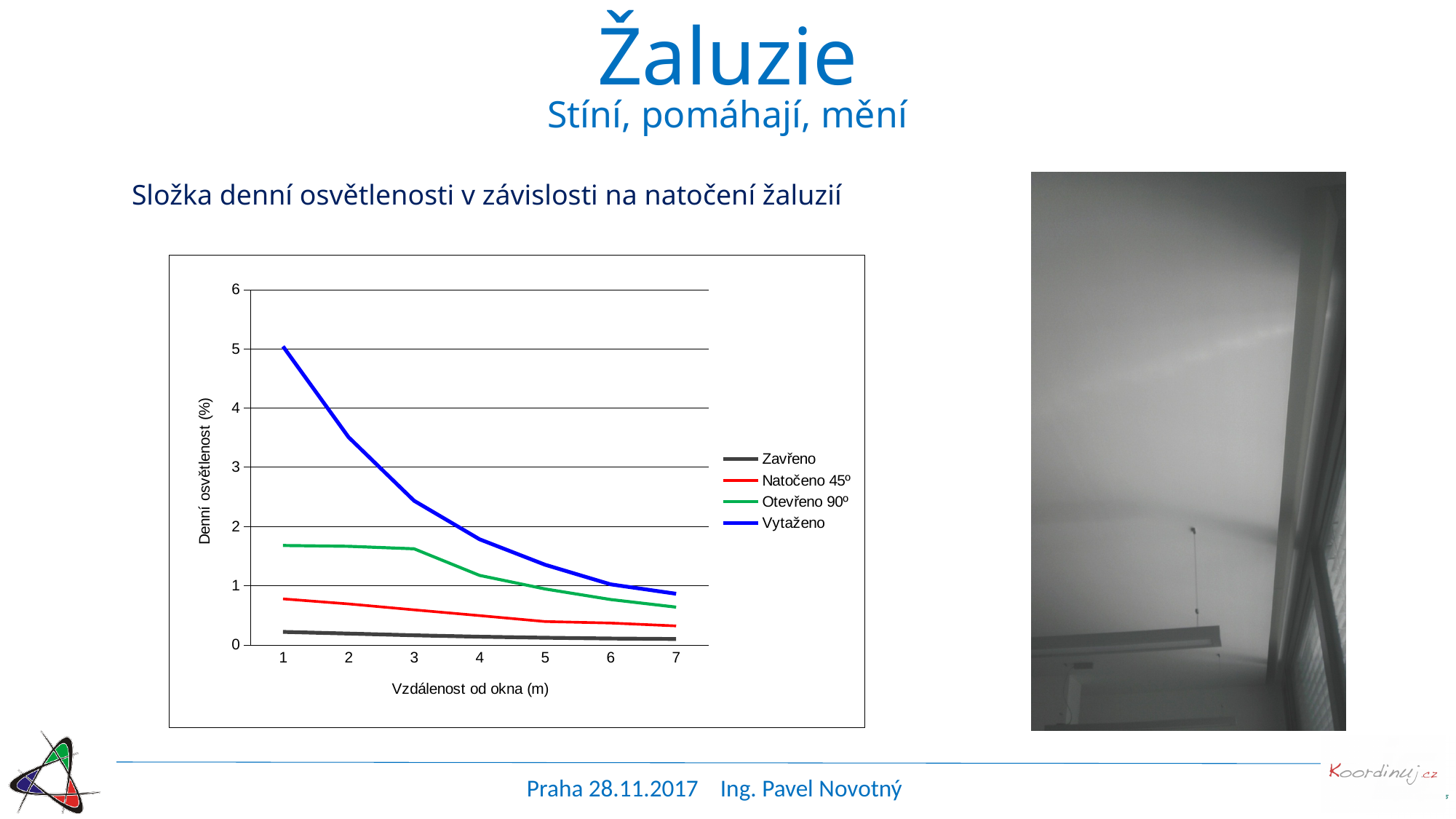
Is the value for Natočeno 45º at 1 m greater or less than 1? less Is the value for Otevřeno 90º at 1 m greater or less than 1? greater How many series does the chart legend list? 4 How many distance points are plotted along the x axis of the chart? 7 Does the Vytaženo series rise or fall as the distance from the window increases? fall Which series has the lowest value across the whole chart? Zavřeno At 3 m from the window, which is larger: the value for Vytaženo or for Otevřeno 90º? Vytaženo Which series has the highest value at a distance of 1 m from the window? Vytaženo What kind of chart is shown on the slide? line chart Is the value for Vytaženo at 7 m greater or less than 1? less What is the title of the x axis of the chart? Vzdálenost od okna (m)